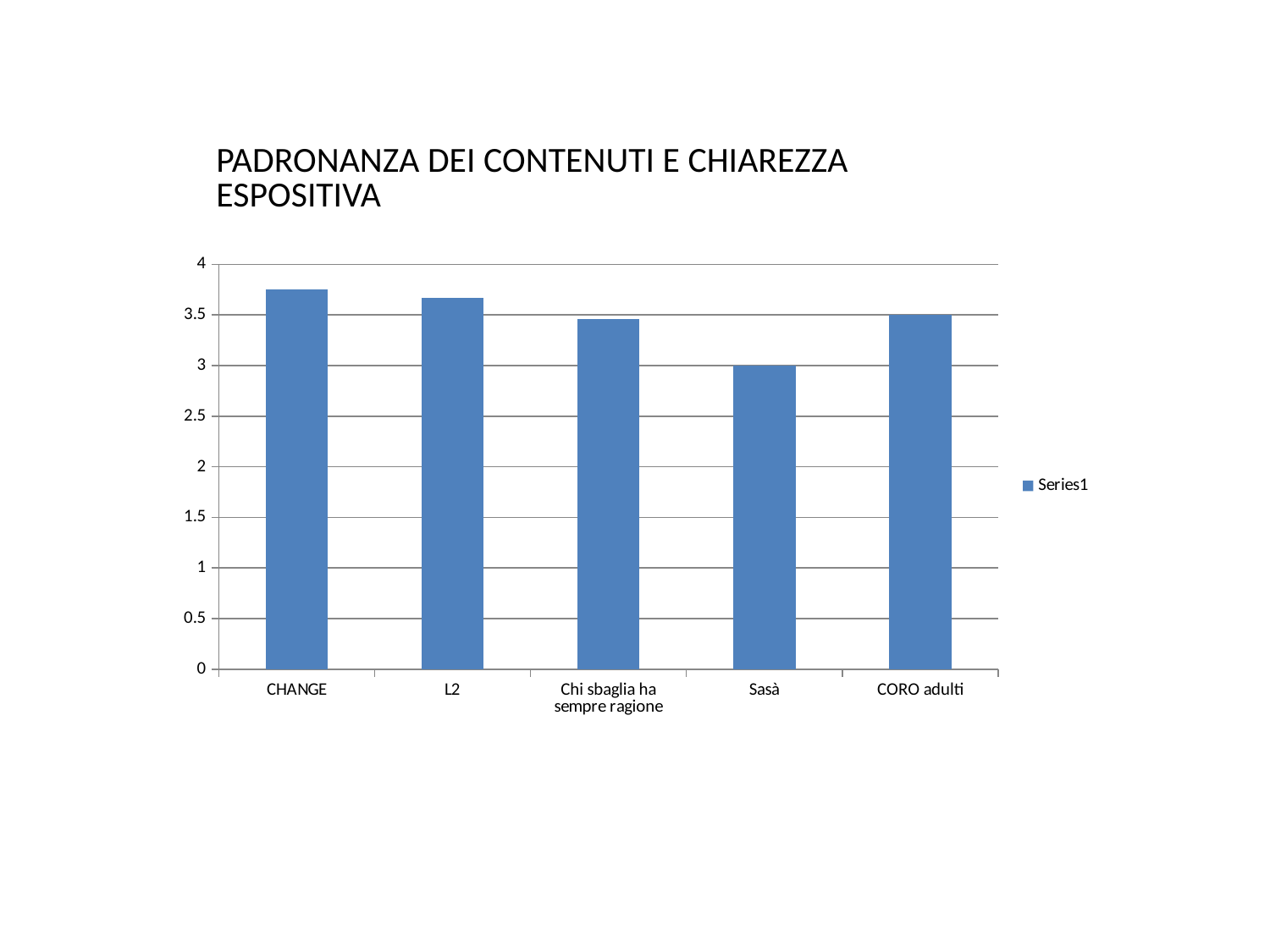
What is the value for CORO adulti? 3.5 What kind of chart is shown on the slide? bar chart Which is larger, the value for L2 or the value for Chi sbaglia ha sempre ragione? L2 How many categories are shown on the x axis of the chart? 5 What is the value for Sasà? 3 Which is larger, the value for Sasà or the value for CHANGE? CHANGE Is the value for Chi sbaglia ha sempre ragione greater or less than 3? greater Which category has the highest value in the chart? CHANGE Is the value for CHANGE greater or less than 3.5? greater How many series does the chart's legend list? 1 What is the title of the chart? PADRONANZA DEI CONTENUTI E CHIAREZZA ESPOSITIVA Which category has the lowest value in the chart? Sasà